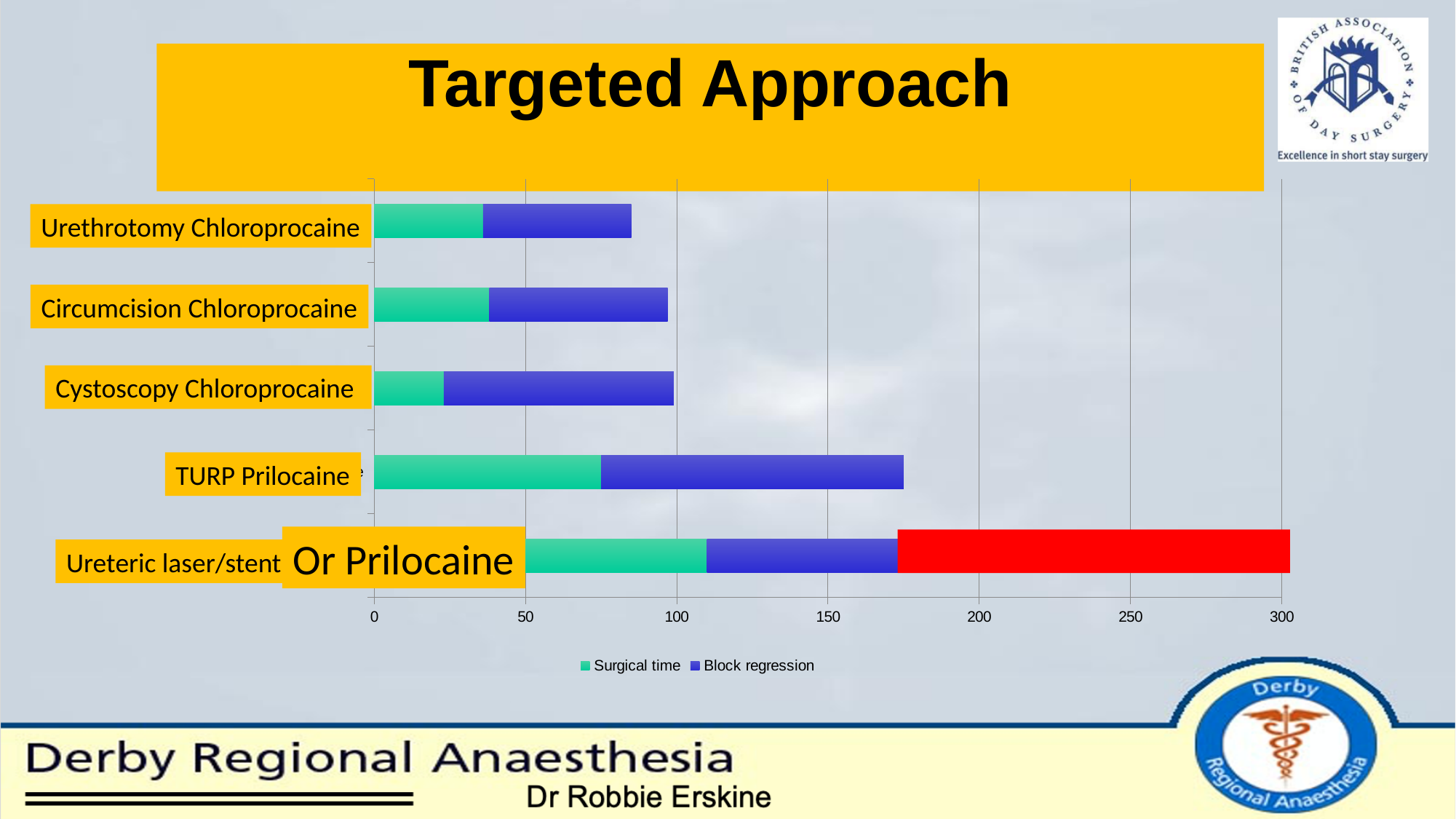
Which has the larger total bar, TURP Prilocaine or Cystoscopy Chloroprocaine? TURP Prilocaine Which procedure has the longest total bar? Ureteric laser/stent Which series is shown in green in the legend? Surgical time Is the total bar length for TURP Prilocaine greater or less than 150? greater How many series does the chart legend list? 2 Is the total bar length for Urethrotomy Chloroprocaine greater or less than 100? less How many procedure categories are plotted on the chart? 5 Is the Surgical time value for Cystoscopy Chloroprocaine greater or less than 50? less What is the title shown above the chart? Targeted Approach Which procedure has the shortest total bar? Urethrotomy Chloroprocaine What kind of chart is shown on the slide? Bar chart